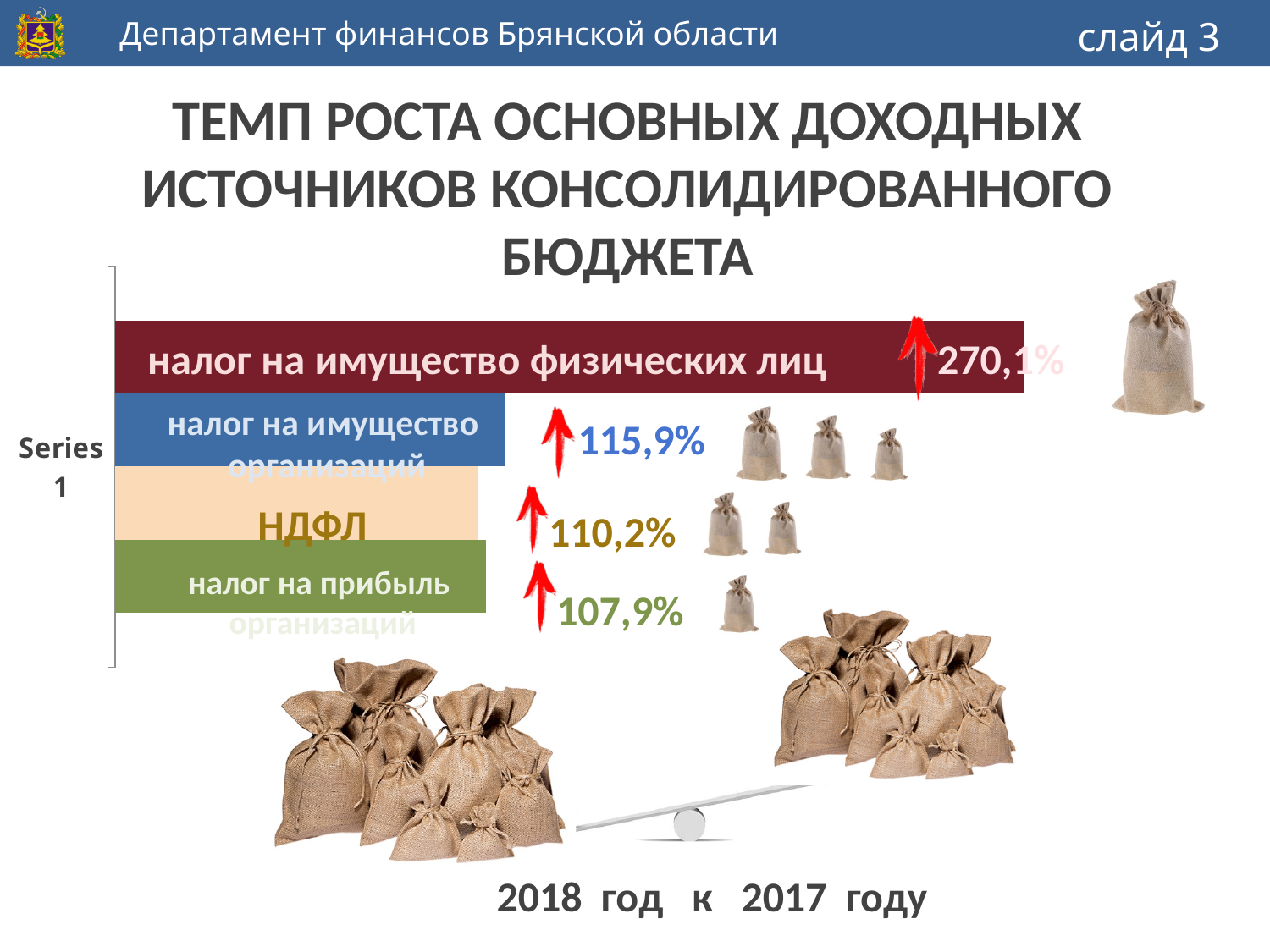
What is the growth rate shown for НДФЛ? 110,2% Which two years does the chart compare, according to the caption below it? 2018 год к 2017 году What is the growth rate shown for налог на имущество организаций? 115,9% Which revenue source has the lowest growth rate on the chart? налог на прибыль организаций What is the growth rate shown for налог на прибыль организаций? 107,9% What is the growth rate shown for налог на имущество физических лиц? 270,1% What kind of chart is shown on the slide? bar chart Which has a higher growth rate, НДФЛ or налог на прибыль организаций? НДФЛ What is the difference between the growth rates of налог на имущество физических лиц and налог на прибыль организаций? 162,2% How many revenue sources (bars) are shown on the chart? 4 What is the difference between the growth rates of налог на имущество организаций and НДФЛ? 5,7% Which revenue source has the highest growth rate on the chart? налог на имущество физических лиц